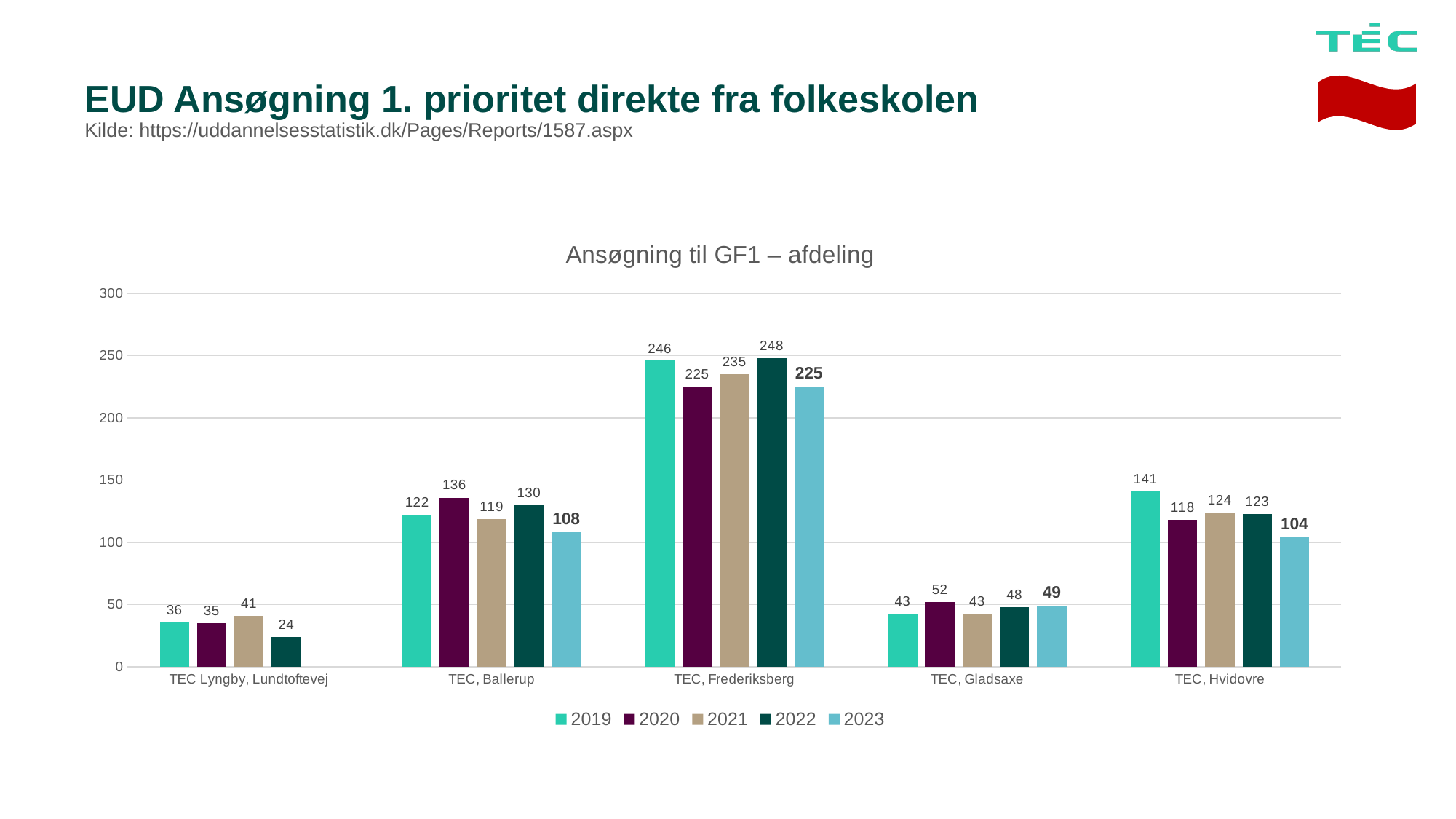
What is the difference between the 2019 and 2023 values for TEC, Hvidovre? 37 What is the value for TEC, Frederiksberg in 2022? 248 How many series does the legend list? 5 How many categories are shown on the x axis? 5 Is the value for TEC, Gladsaxe in 2020 greater or less than 100? less What is the value for TEC Lyngby, Lundtoftevej in 2021? 41 What is the title of the chart? Ansøgning til GF1 – afdeling Which category has the highest value in 2019? TEC, Frederiksberg What is the value for TEC, Hvidovre in 2023? 104 Which is larger for TEC, Ballerup: the 2020 value or the 2023 value? 2020 What kind of chart is shown on the slide? bar chart Which category has the lowest value in 2022? TEC Lyngby, Lundtoftevej